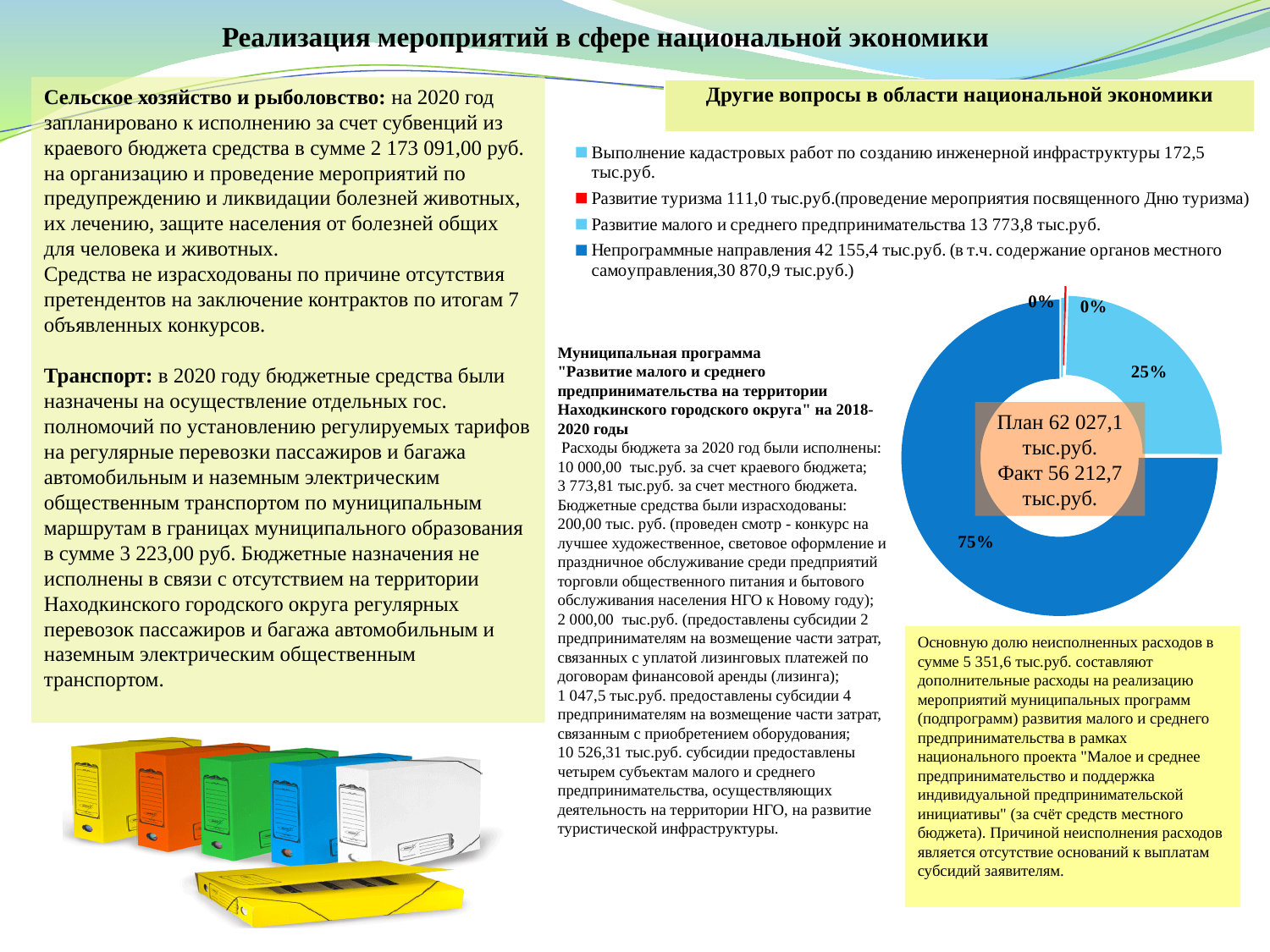
What share of the pie chart does "Развитие малого и среднего предпринимательства" take? 25% How many categories does the legend of the pie chart list? 4 What is the difference in percentage points between the 75% slice and the 25% slice in the pie chart? 50% What share is shown for "Развитие туризма" in the pie chart? 0% What fact value (Факт) is printed in the centre of the pie chart? 56 212,7 тыс.руб. Which category has the largest slice in the pie chart? Непрограммные направления What share of the pie chart does "Непрограммные направления" take? 75% Which slice is larger in the pie chart: "Непрограммные направления" or "Развитие малого и среднего предпринимательства"? Непрограммные направления What kind of chart is shown under the heading "Другие вопросы в области национальной экономики"? Pie (doughnut) chart What amount is given for "Развитие туризма" in the legend of the pie chart? 111,0 тыс.руб. What plan value (План) is printed in the centre of the pie chart? 62 027,1 тыс.руб. How many slices are labelled in the pie chart? 4